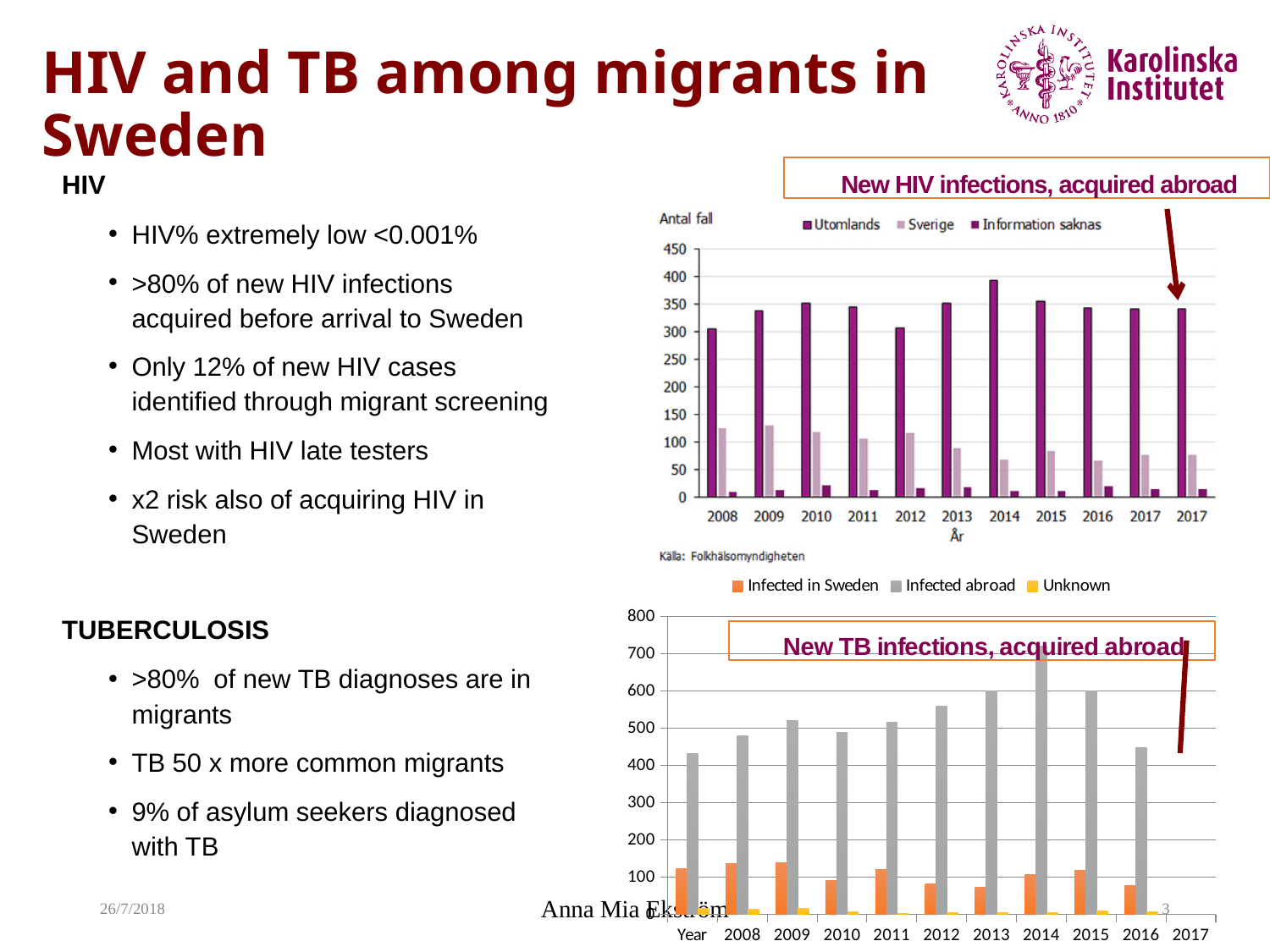
In the bottom chart (New TB infections), is the Infected in Sweden value for 2009 greater or less than 200? less In the top chart (New HIV infections), is the Utomlands value for 2014 greater or less than 350? greater In the top chart (New HIV infections), which year has the highest Utomlands bar? 2014 How many series does the legend of the bottom chart (New TB infections, acquired abroad) list? 3 In the bottom chart (New TB infections), which year has the highest Infected abroad bar? 2014 In the top chart (New HIV infections), is the Sverige value for 2008 greater or less than 100? greater In the bottom chart (New TB infections), what colour represents the Unknown series? yellow What source is cited below the top chart (New HIV infections)? Folkhälsomyndigheten In the top chart (New HIV infections), which is larger for 2014: Utomlands or Sverige? Utomlands In the bottom chart (New TB infections), do the Infected abroad values rise or fall from 2014 to 2016? fall What kind of chart is the top chart (New HIV infections, acquired abroad)? bar chart